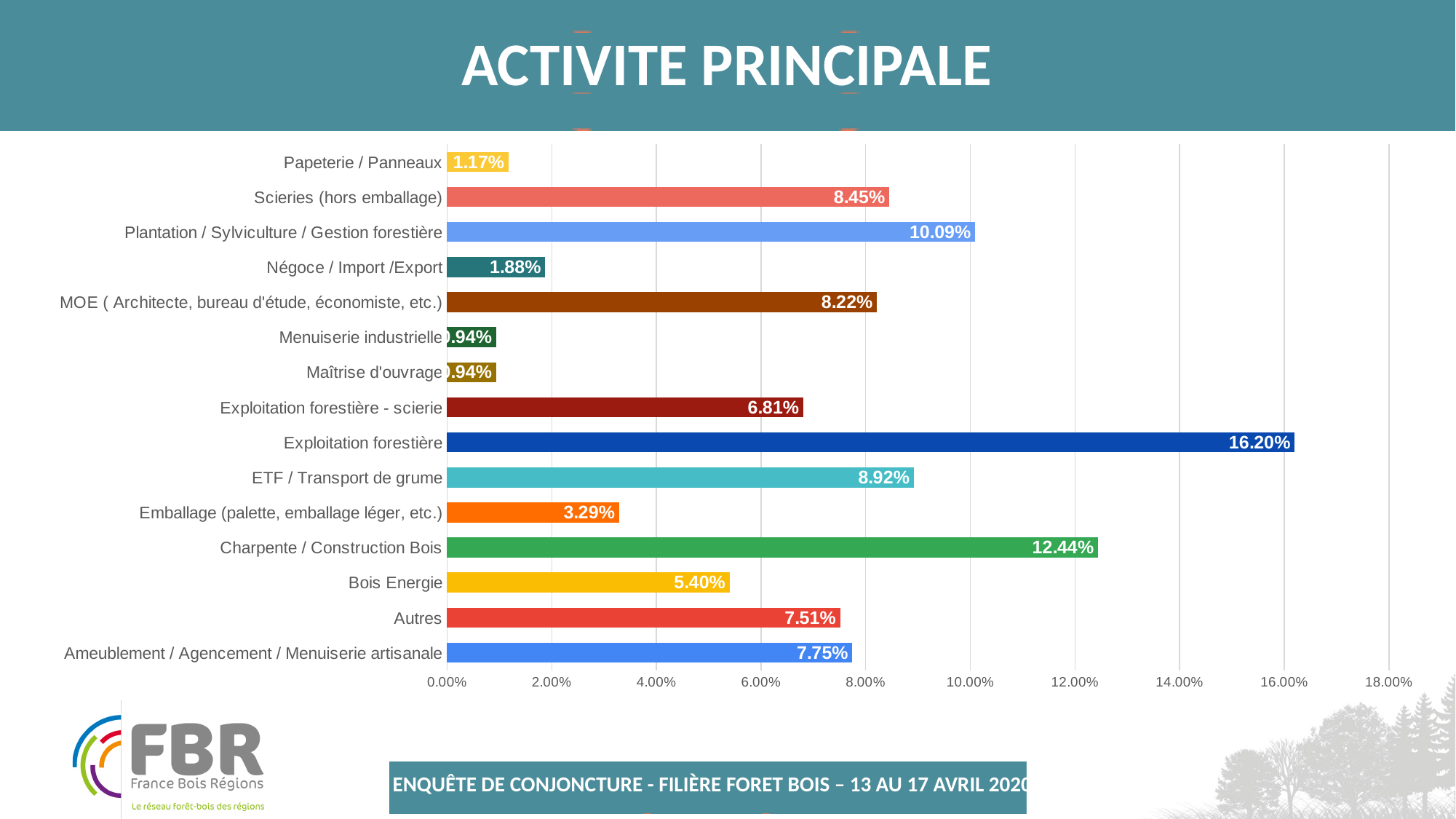
What kind of chart is shown on the slide? bar chart How many categories are shown in the chart? 15 Which is larger, the value for ETF / Transport de grume or the value for MOE ( Architecte, bureau d'étude, économiste, etc.)? ETF / Transport de grume Which category has the highest value? Exploitation forestière Is the value for Plantation / Sylviculture / Gestion forestière greater or less than 10.00%? greater What is the title of the slide? ACTIVITE PRINCIPALE What is the value for Bois Energie? 5.40% What is the difference between the values for Scieries (hors emballage) and Autres? 0.94% What is the value for Papeterie / Panneaux? 1.17% What is the value for Exploitation forestière? 16.20% What is the difference between the values for Exploitation forestière and Charpente / Construction Bois? 3.76% What is the value for Charpente / Construction Bois? 12.44%